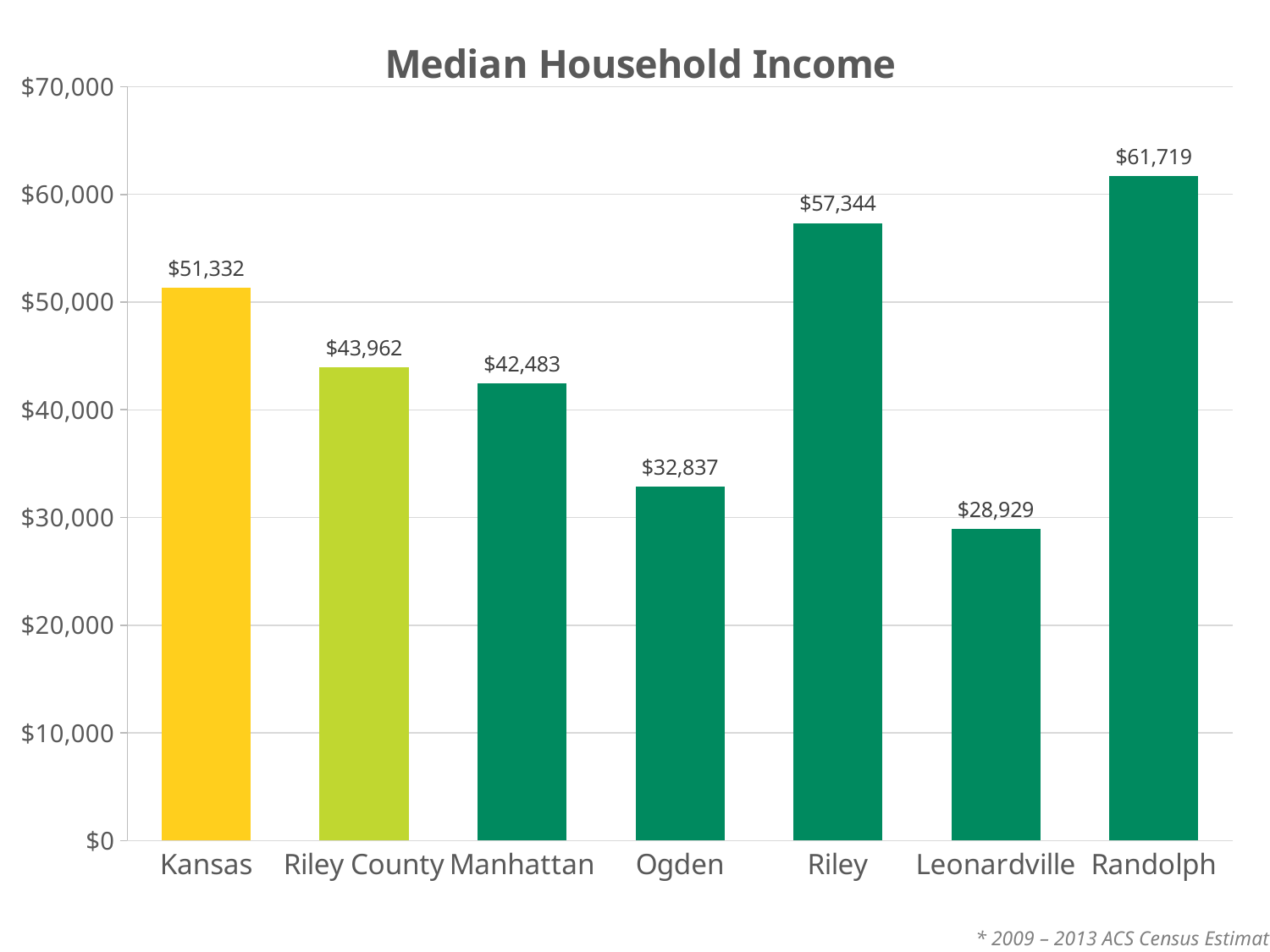
What type of chart is shown on the slide? Bar chart How many categories are shown in the chart? 7 What is the median household income for Manhattan? $42,483 Which has a higher median household income, Riley or Kansas? Riley What is the difference between the median household income of Kansas and Manhattan? $8,849 Which category has the highest median household income? Randolph Is the median household income for Ogden greater or less than $30,000? greater What is the median household income for Leonardville? $28,929 What is the difference between the median household income of Randolph and Leonardville? $32,790 What is the title of the chart? Median Household Income What is the median household income for Riley County? $43,962 Which category has the lowest median household income? Leonardville